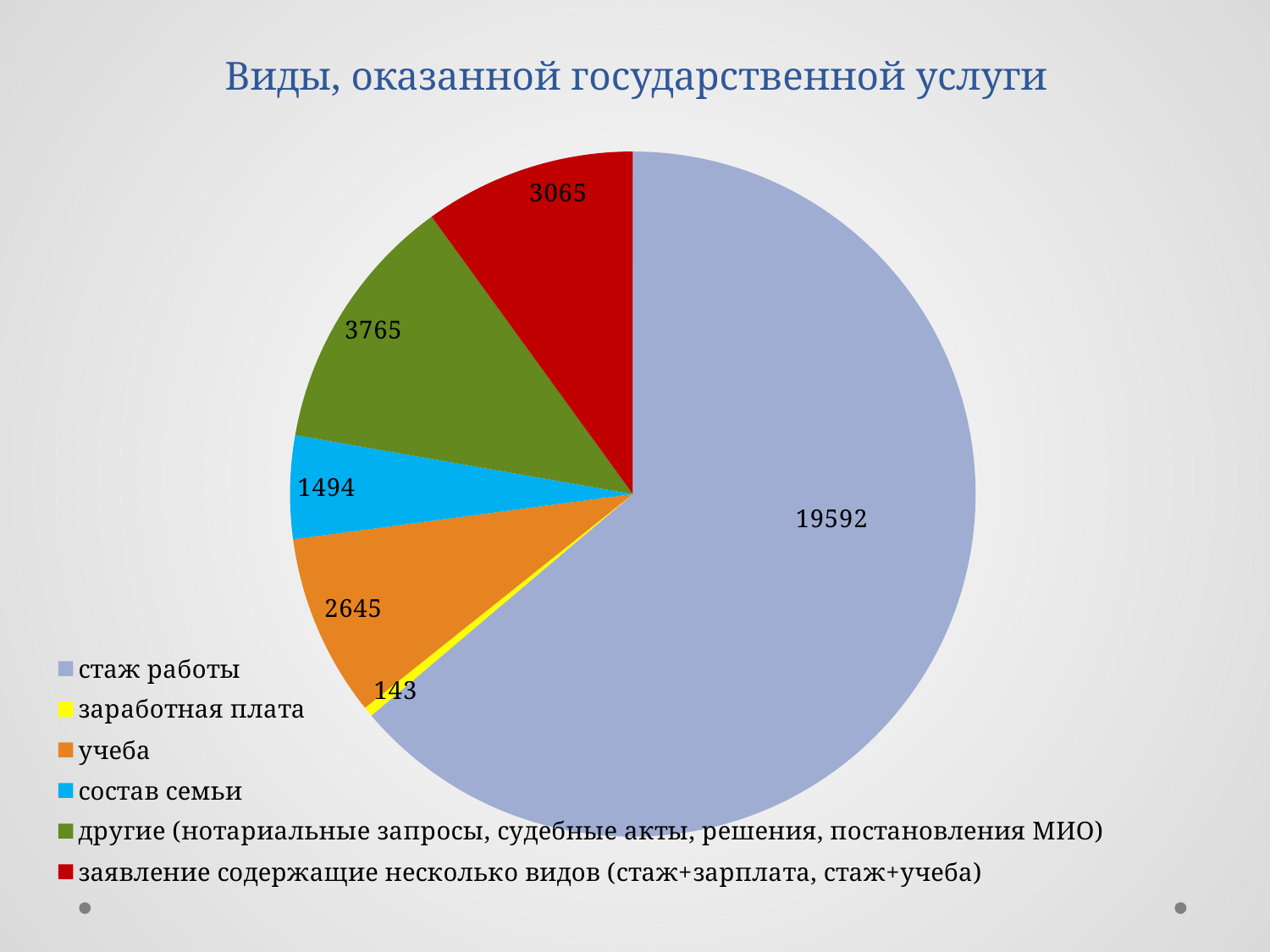
What is the value for учеба? 2645 What is the difference between the values for другие (нотариальные запросы, судебные акты, решения, постановления МИО) and заявление содержащие несколько видов (стаж+зарплата, стаж+учеба)? 700 How many categories does the pie chart have? 6 Which is larger, the value for учеба or the value for состав семьи? учеба Which category has the smallest slice of the pie? заработная плата What is the title of the chart? Виды, оказанной государственной услуги What kind of chart is shown on the slide? pie chart What is the value for состав семьи? 1494 What is the total of all the slices in the pie chart? 30704 Which category has the largest slice of the pie? стаж работы What is the value for заработная плата? 143 What is the value for стаж работы? 19592